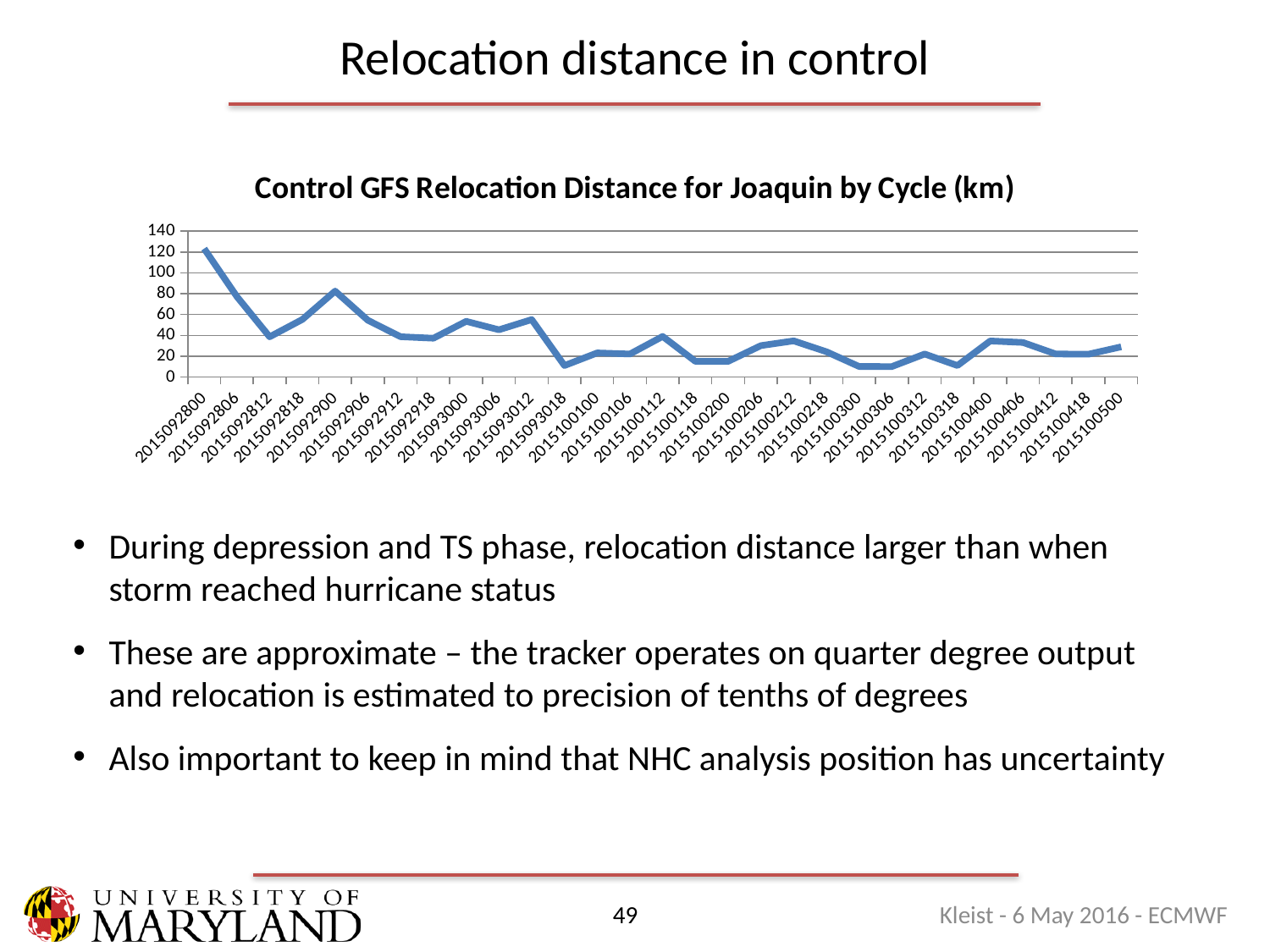
How many cycles are labelled on the x axis? 29 Overall, do the values rise or fall from the first cycle to the last cycle along the x axis? fall Is the value for 2015092812 greater or less than 60? less Which cycle has the highest relocation distance? 2015092800 What kind of chart is shown on the slide? line chart Which has the larger relocation distance, 2015092800 or 2015092900? 2015092800 Is the value for 2015092900 greater or less than 60? greater Is the value for 2015092800 greater or less than 100? greater What is the title of the chart? Control GFS Relocation Distance for Joaquin by Cycle (km) Which has the larger relocation distance, 2015093012 or 2015093018? 2015093012